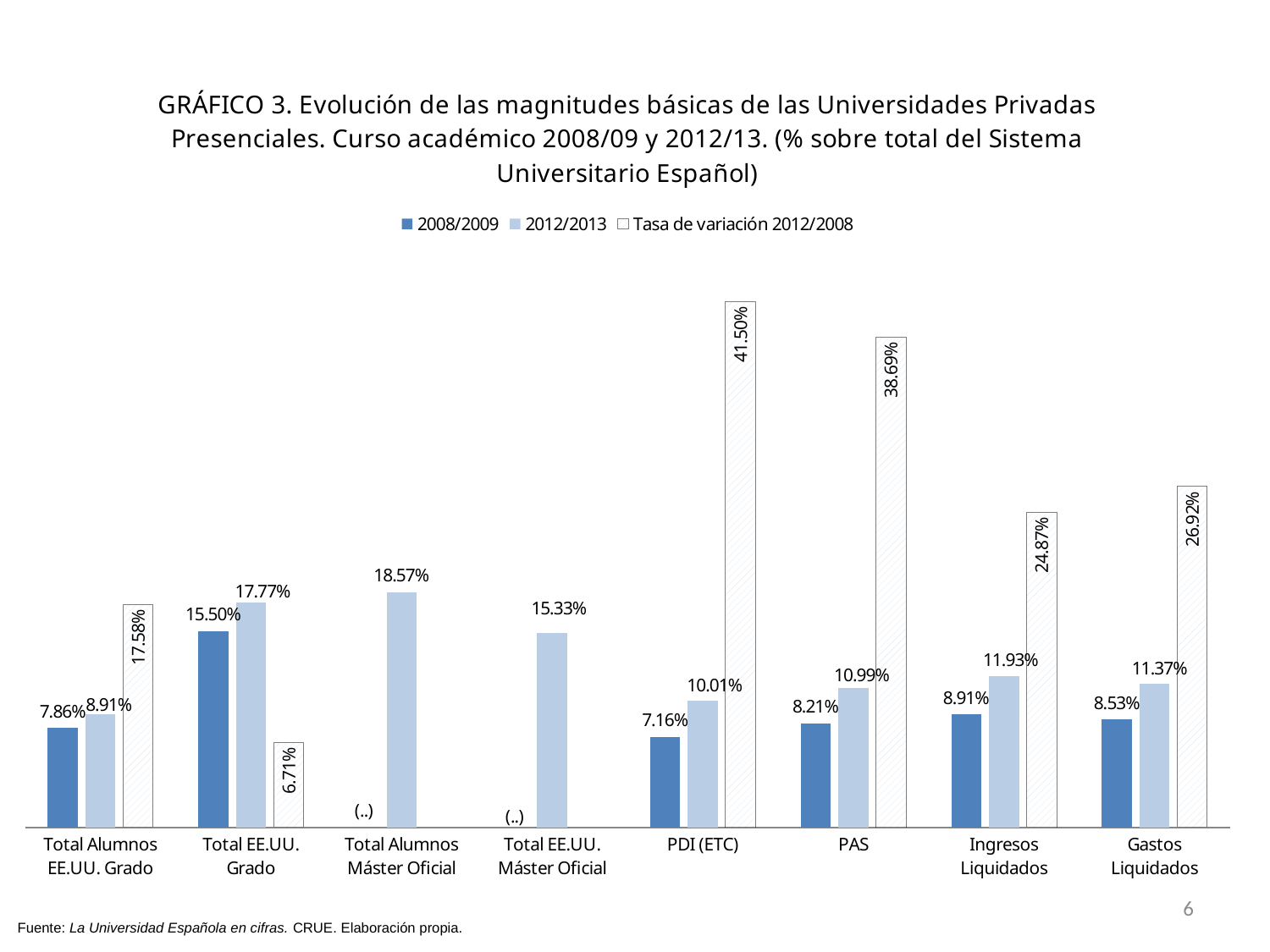
How many series does the legend list? 3 Which category has the lowest 2008/2009 value? PDI (ETC) What is the 2008/2009 value for Ingresos Liquidados? 8.91% What is the difference between the 2012/2013 and 2008/2009 values for Total EE.UU. Grado? 2.27% Which category has the highest Tasa de variación 2012/2008 value? PDI (ETC) Which category has the highest 2012/2013 value? Total Alumnos Máster Oficial Which is larger, the Tasa de variación 2012/2008 for Ingresos Liquidados or for Gastos Liquidados? Gastos Liquidados What kind of chart is shown on the slide? Bar chart What is the Tasa de variación 2012/2008 value for PAS? 38.69% What is the 2012/2013 value for PDI (ETC)? 10.01% How many categories are shown on the x axis? 8 What label is shown in place of the 2008/2009 bar for Total Alumnos Máster Oficial? (..)